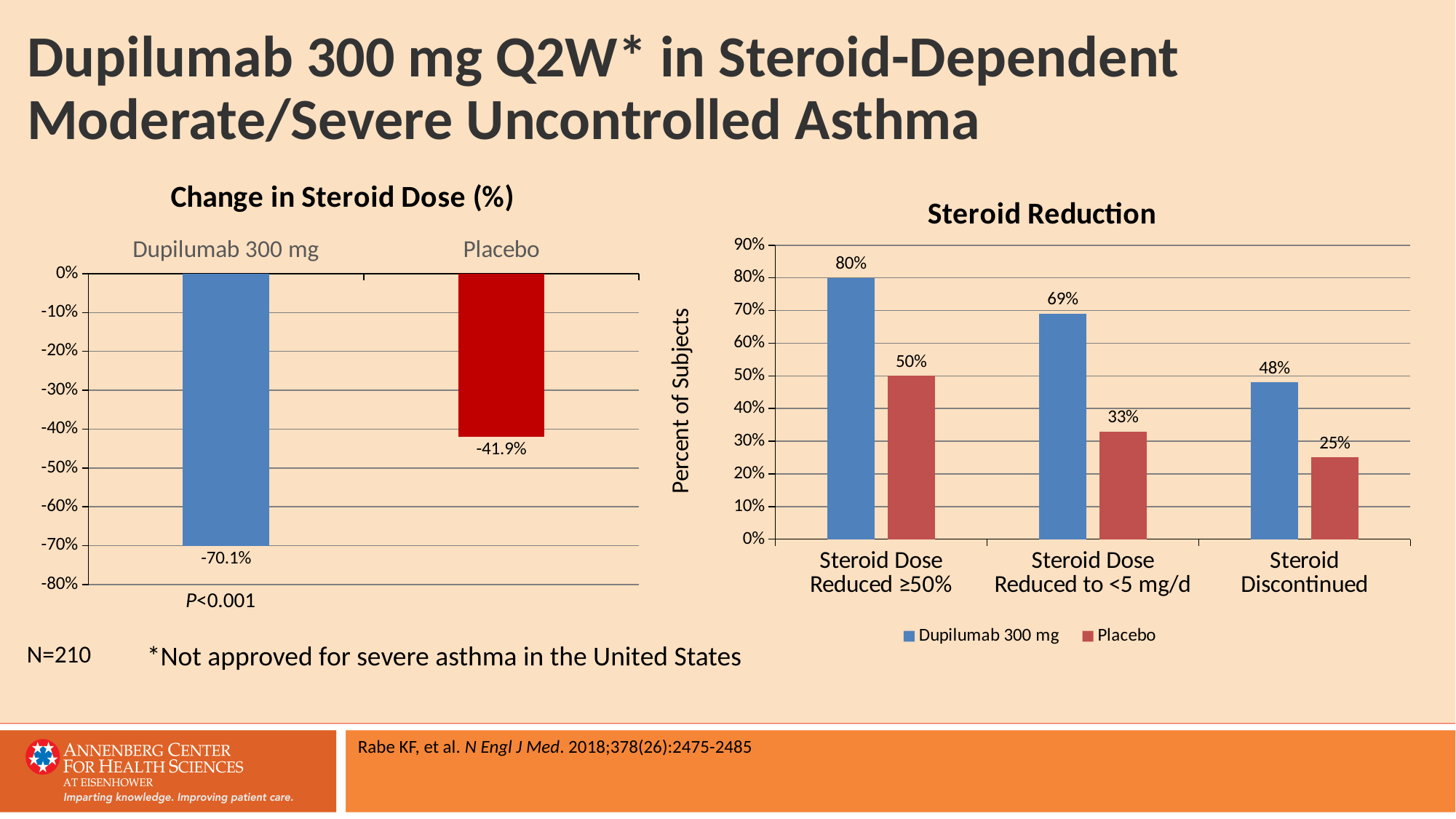
In the 'Steroid Reduction' chart, what is the value for Placebo in the 'Steroid Discontinued' category? 25% In the 'Steroid Reduction' chart, what is the difference between Dupilumab 300 mg and Placebo in the 'Steroid Dose Reduced to <5 mg/d' category? 36 percentage points In the 'Steroid Reduction' chart, what is the value for Placebo in the 'Steroid Dose Reduced to <5 mg/d' category? 33% In the 'Steroid Reduction' chart, which is larger in the 'Steroid Discontinued' category: Dupilumab 300 mg or Placebo? Dupilumab 300 mg In the 'Steroid Reduction' chart, how many series does the legend list? 2 In the 'Change in Steroid Dose (%)' chart, what is the value for Placebo? -41.9% In the 'Change in Steroid Dose (%)' chart, what is the difference between the Placebo and Dupilumab 300 mg values? 28.2 percentage points In the 'Steroid Reduction' chart, which category has the highest Dupilumab 300 mg value? Steroid Dose Reduced ≥50% What type of chart is the 'Steroid Reduction' chart? Bar chart In the 'Change in Steroid Dose (%)' chart, how many bars are plotted? 2 In the 'Change in Steroid Dose (%)' chart, what is the value for Dupilumab 300 mg? -70.1% In the 'Steroid Reduction' chart, what is the value for Dupilumab 300 mg in the 'Steroid Dose Reduced ≥50%' category? 80%